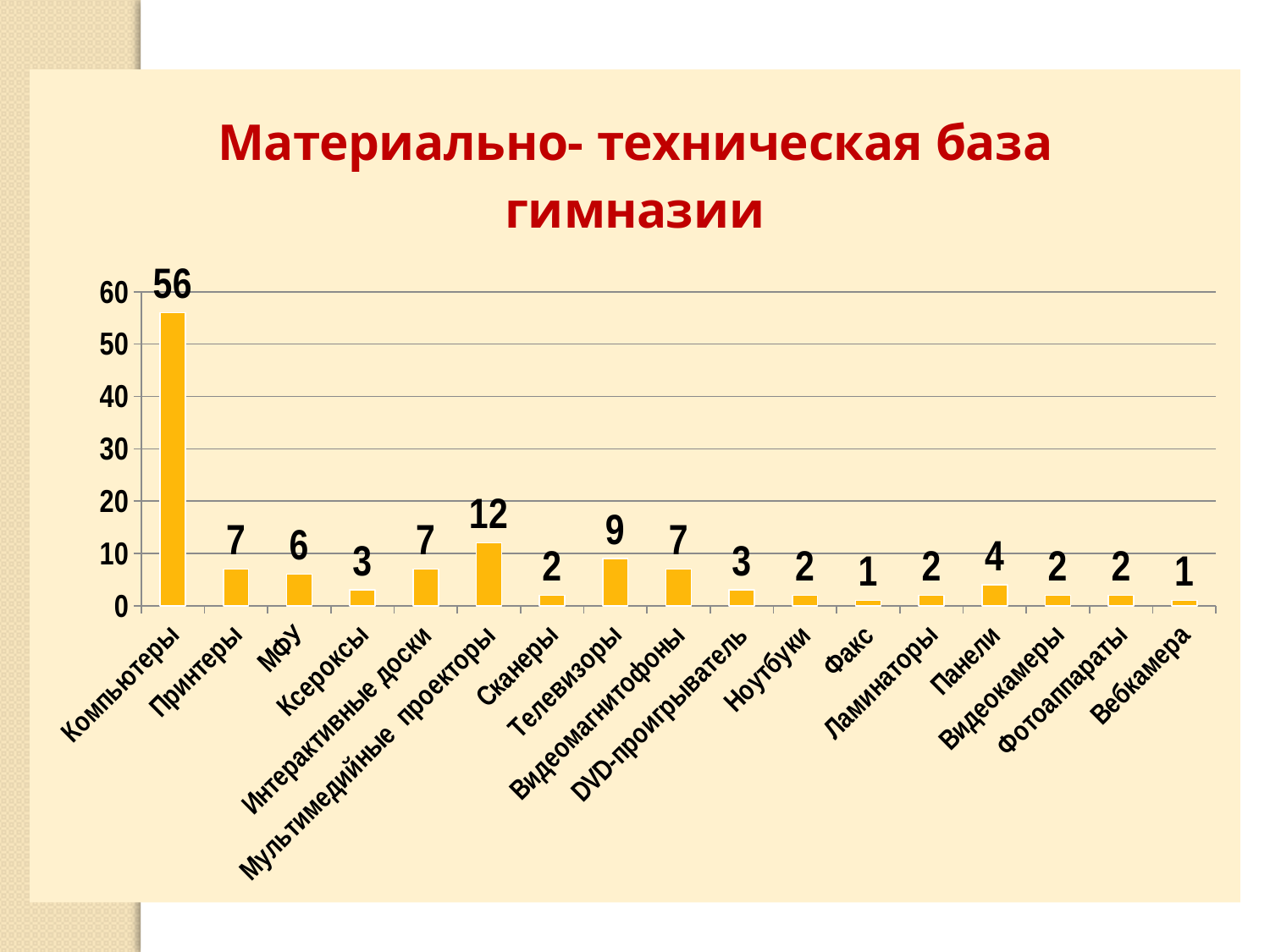
What is the title of the chart? Материально- техническая база гимназии What is the difference between the values for Телевизоры and МФУ? 3 What is the value for Компьютеры? 56 What kind of chart is shown on the slide? bar chart Which category has the highest value? Компьютеры What is the value for Панели? 4 Is the value for Компьютеры greater or less than 50? greater What is the difference between the values for Компьютеры and Мультимедийные проекторы? 44 What is the value for Телевизоры? 9 Which is larger, the value for Принтеры or the value for Ксероксы? Принтеры What is the value for Мультимедийные проекторы? 12 How many categories are shown on the x axis? 17